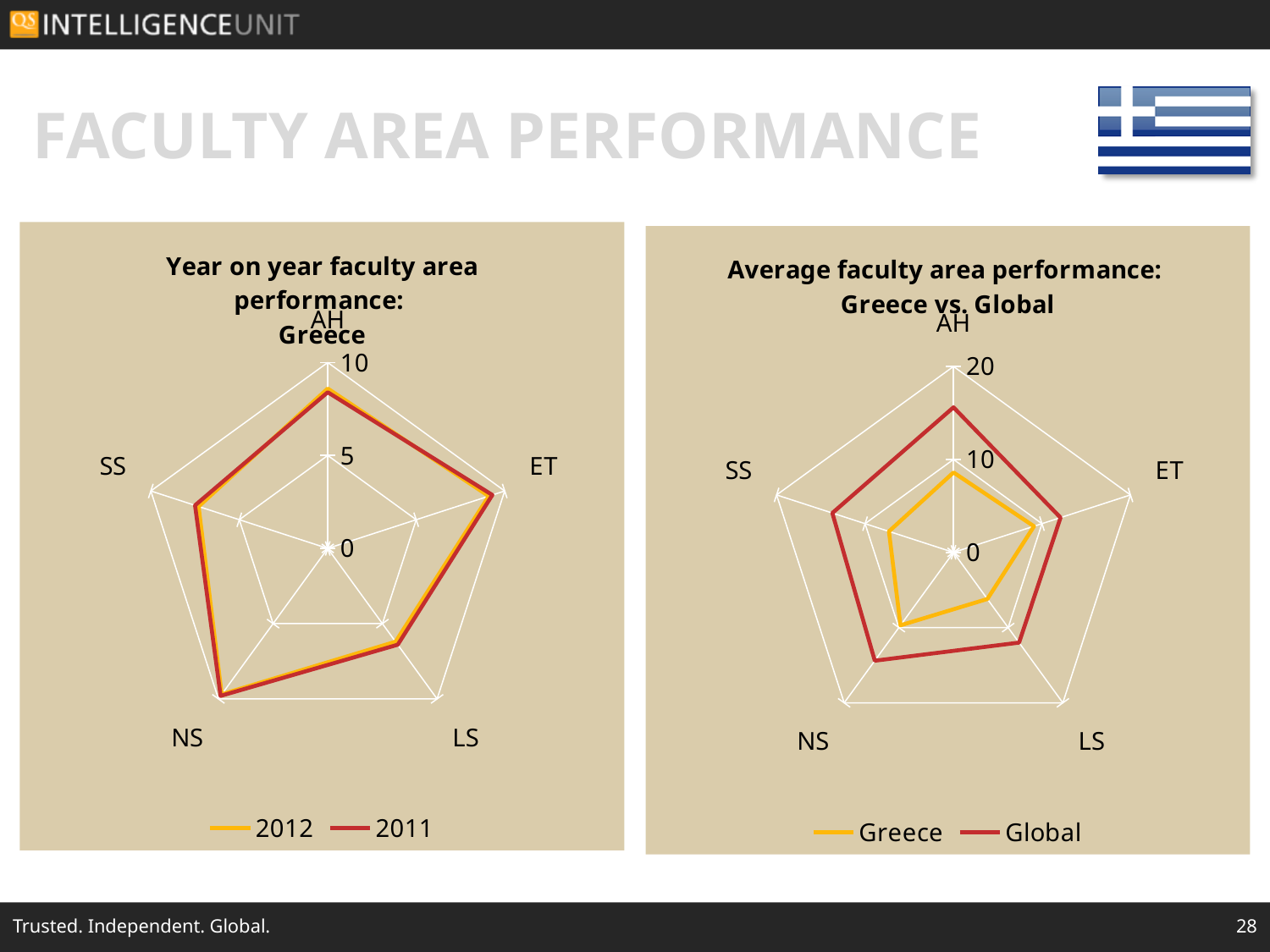
What type of chart is the left chart, 'Year on year faculty area performance: Greece'? Radar chart On the right chart, 'Average faculty area performance: Greece vs. Global', which series has the larger value for AH, Greece or Global? Global On the right chart, 'Average faculty area performance: Greece vs. Global', which series has the larger value for LS, Greece or Global? Global On the right chart, 'Average faculty area performance: Greece vs. Global', is the Global value for AH greater or less than 10? greater How many series does the legend of the left chart, 'Year on year faculty area performance: Greece', list? 2 On the left chart, 'Year on year faculty area performance: Greece', is the 2011 value for LS greater or less than 5? greater How many faculty area categories are plotted on the right chart, 'Average faculty area performance: Greece vs. Global'? 5 On the left chart, 'Year on year faculty area performance: Greece', is the 2012 value for NS greater or less than 5? greater What is the title of the left chart on the slide? Year on year faculty area performance: Greece What are the two series named in the legend of the right chart, 'Average faculty area performance: Greece vs. Global'? Greece and Global